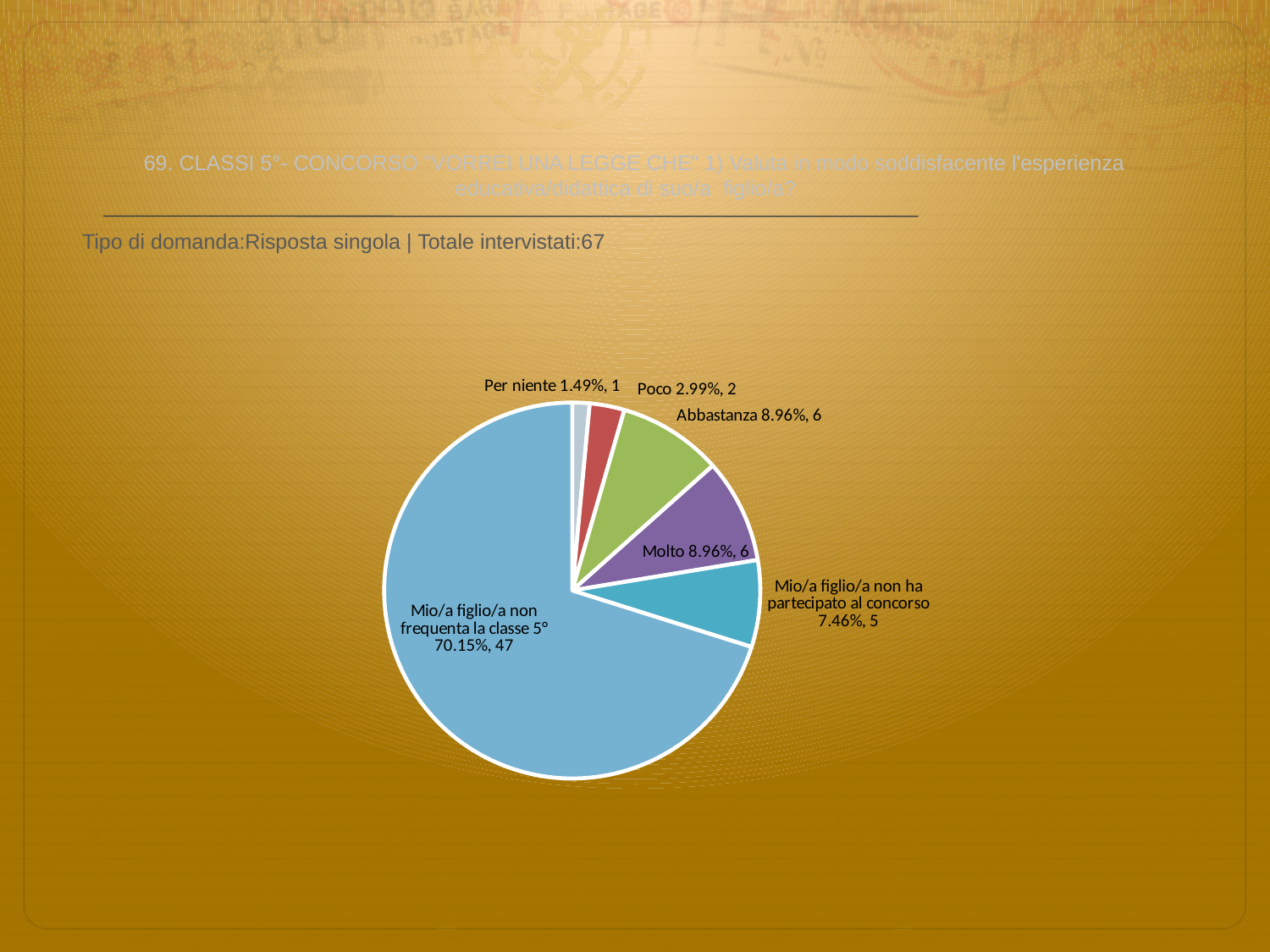
What kind of chart is shown on the slide? Pie chart Which has more respondents, "Poco" or "Mio/a figlio/a non ha partecipato al concorso"? Mio/a figlio/a non ha partecipato al concorso Which category has the largest slice of the pie? Mio/a figlio/a non frequenta la classe 5° Which category has the smallest slice of the pie? Per niente What percentage is shown for "Mio/a figlio/a non ha partecipato al concorso"? 7.46% What percentage is shown for "Poco"? 2.99% How many respondents answered "Abbastanza"? 6 According to the text above the chart, what is the total number of interviewees (Totale intervistati)? 67 How many slices does the pie chart have? 6 What percentage share does the slice "Mio/a figlio/a non frequenta la classe 5°" have? 70.15% What is the difference in count between "Mio/a figlio/a non frequenta la classe 5°" and "Molto"? 41 How many respondents answered "Per niente"? 1